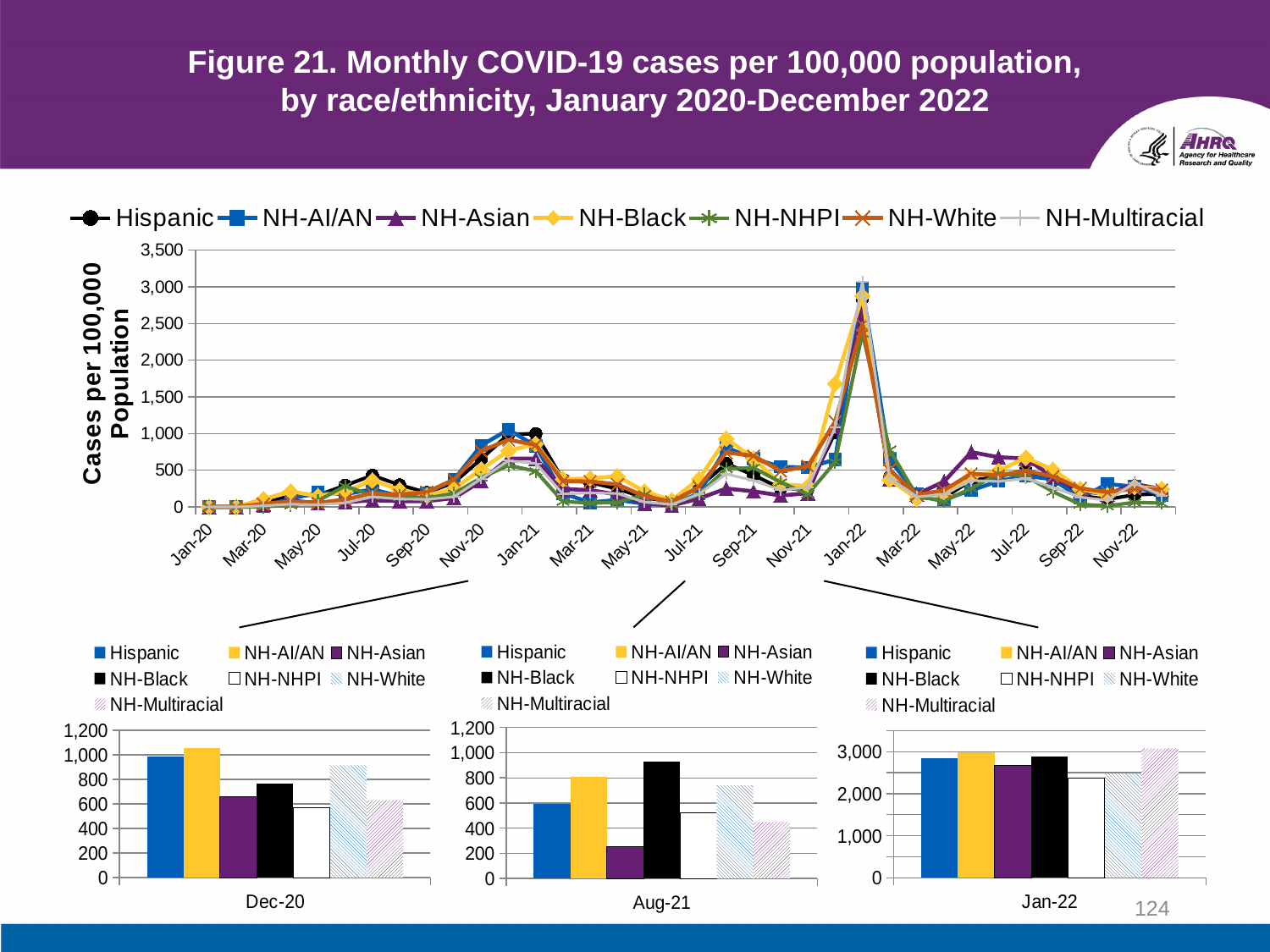
In the Dec-20 bar chart, which group has the highest value? NH-AI/AN In the Aug-21 bar chart, which group has the highest value? NH-Black In the top line chart, do the values rise or fall between Jan-22 and Mar-22? fall In the Jan-22 bar chart, which is larger, the value for NH-AI/AN or the value for NH-NHPI? NH-AI/AN In the Aug-21 bar chart, which group has the lowest value? NH-Asian In the Aug-21 bar chart, is the value for NH-Asian greater or less than 400? less In the Jan-22 bar chart, is the value for NH-NHPI greater or less than 2,000? greater In the Dec-20 bar chart, is the value for NH-AI/AN greater or less than 1,000? greater What kind of chart is the Dec-20 chart at the bottom left? bar chart How many series does the legend of the top line chart list? 7 What kind of chart is the large chart at the top of the slide? line chart In the top line chart, in which month do the lines reach their highest peak? Jan-22